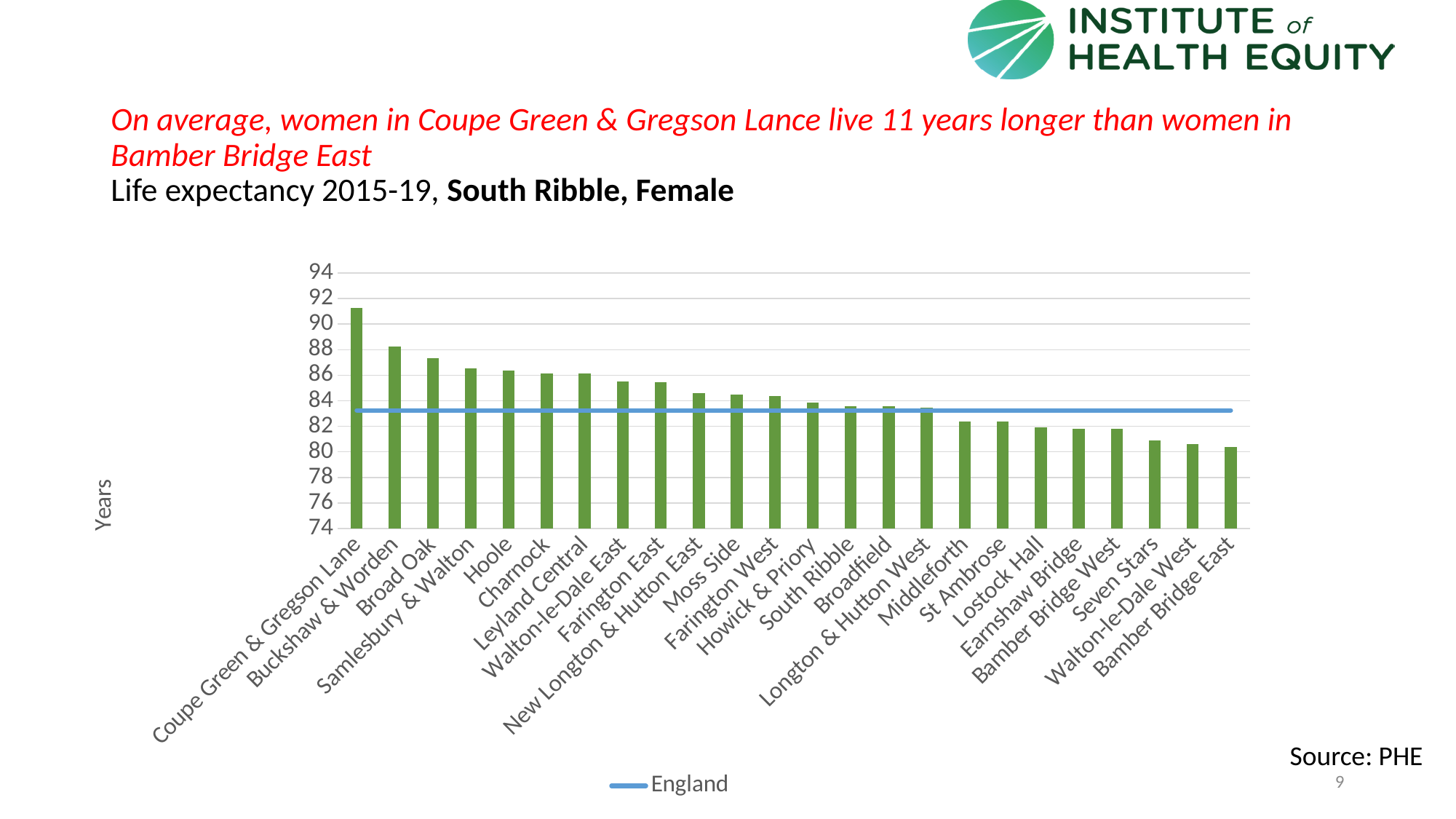
What is the label on the vertical axis of the chart? Years Do the bar values rise or fall from left to right along the x axis? fall What kind of chart is shown on the slide? bar chart How many areas (bars) are plotted on the chart? 24 Is the value for Broad Oak greater or less than 86? greater Which area has the highest female life expectancy on the chart? Coupe Green & Gregson Lane Which area has the lowest female life expectancy on the chart? Bamber Bridge East How many series does the legend list? 1 Is the value for Coupe Green & Gregson Lane greater or less than 90? greater Which has the larger value, Hoole or Middleforth? Hoole What does the horizontal blue line on the chart represent, according to the legend? England Is the value for Seven Stars greater or less than 82? less